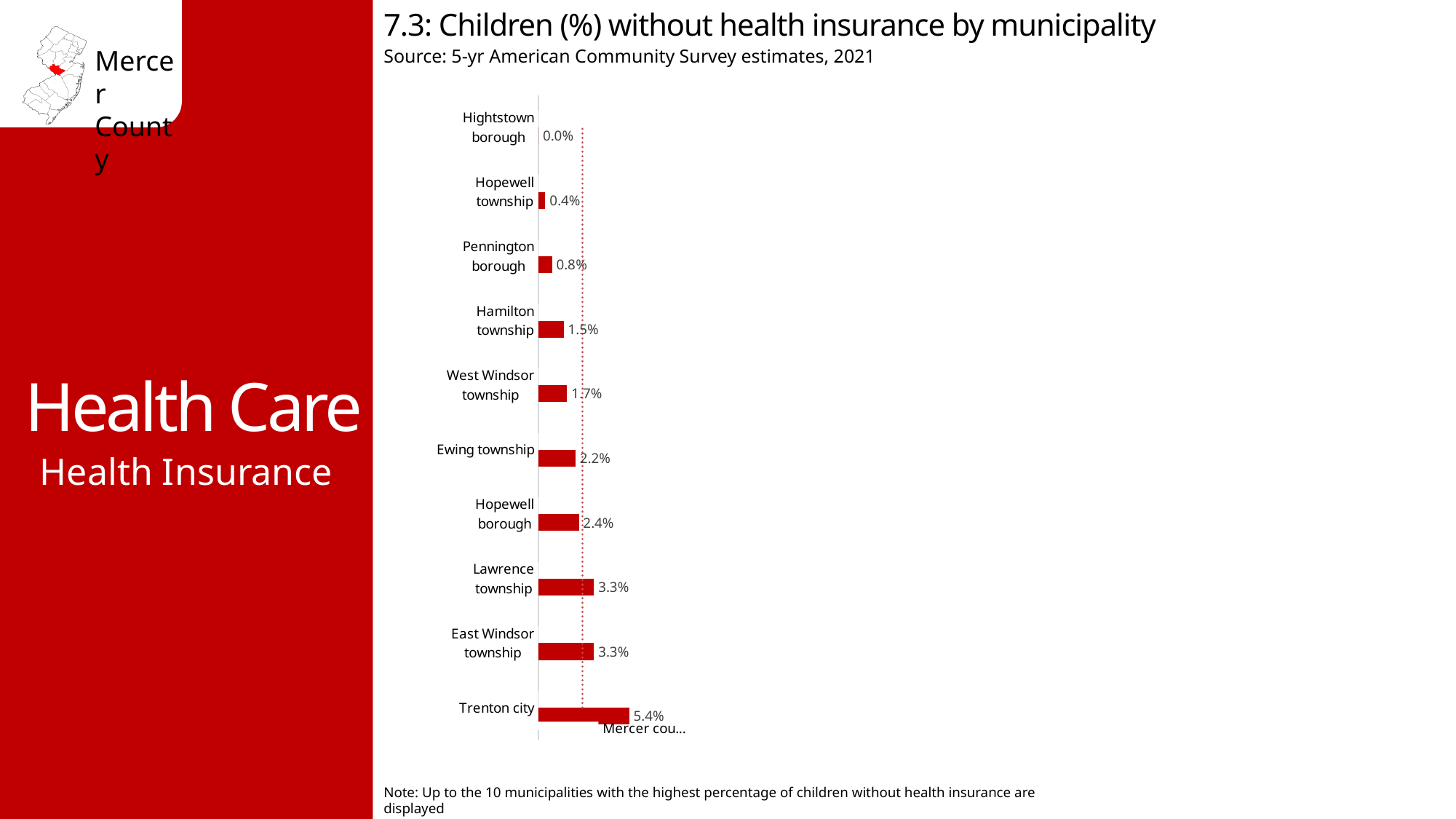
What is the value shown for Ewing township? 2.2% What type of chart is shown on the slide? Bar chart What is the data source cited for the chart? 5-yr American Community Survey estimates, 2021 What is the difference between the values for Trenton city and East Windsor township? 2.1% Which has a higher value, Lawrence township or West Windsor township? Lawrence township What is the value shown for Hamilton township? 1.5% Which municipality has the lowest percentage of children without health insurance? Hightstown borough How many municipalities are shown in the chart? 10 Which municipality has the highest percentage of children without health insurance? Trenton city What is the title of the chart? 7.3: Children (%) without health insurance by municipality What is the difference between the values for Hopewell borough and Hopewell township? 2.0% What percentage of children in Trenton city are without health insurance? 5.4%